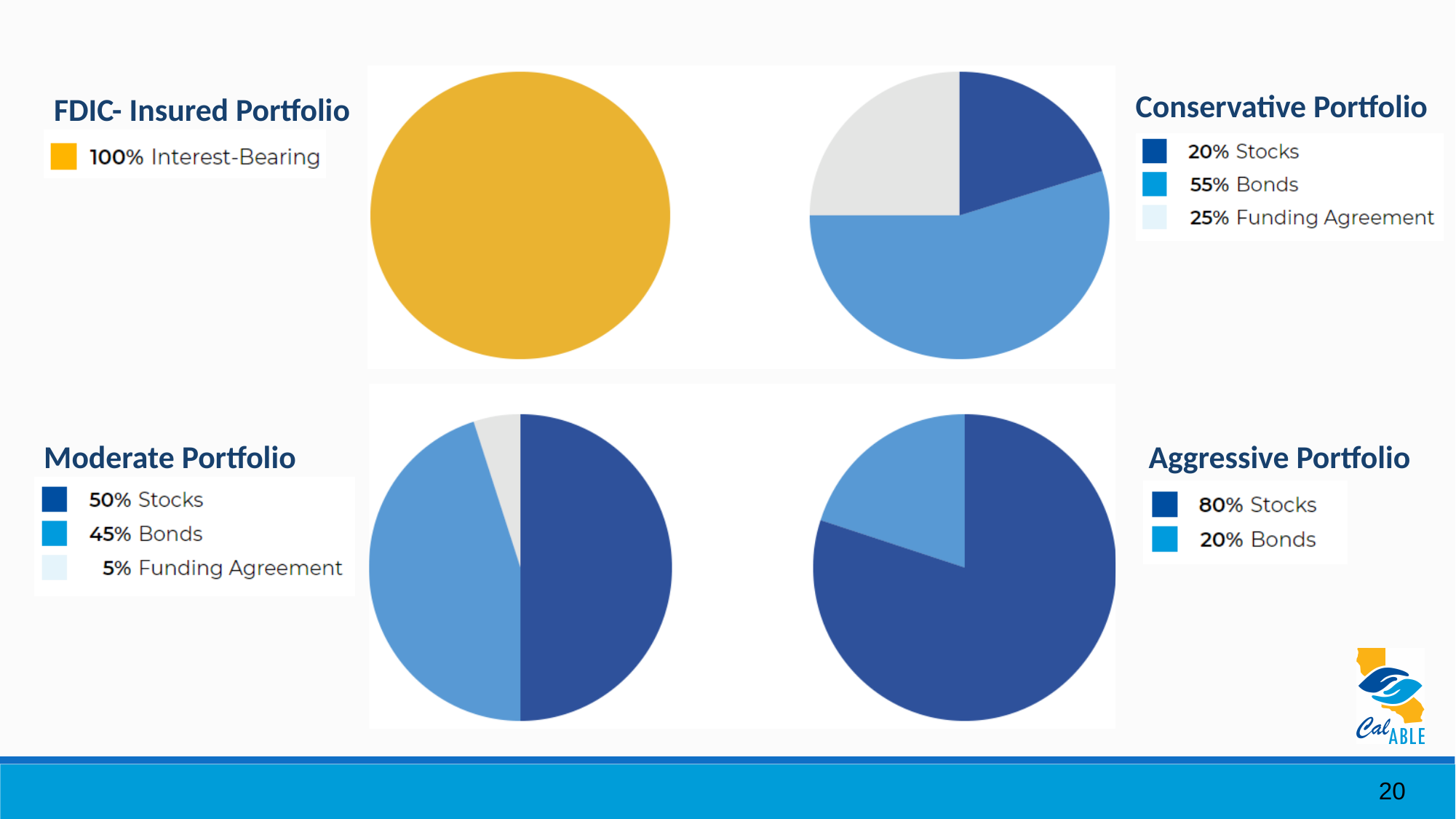
In the Moderate Portfolio chart, what share is Funding Agreement? 5% In the Conservative Portfolio chart, which is larger, Stocks or Funding Agreement? Funding Agreement What kind of chart is the Conservative Portfolio chart? Pie chart How many categories does the Moderate Portfolio chart show? 3 In the FDIC- Insured Portfolio chart, what share is Interest-Bearing? 100% How many pie charts are shown on the slide? 4 In the Conservative Portfolio chart, which category has the largest share? Bonds In the Conservative Portfolio chart, what share is Bonds? 55% In the Aggressive Portfolio chart, what share is Stocks? 80% In the Aggressive Portfolio chart, what is the difference between the Stocks and Bonds shares? 60% In the Moderate Portfolio chart, which category has the smallest share? Funding Agreement How many categories does the Aggressive Portfolio chart show? 2